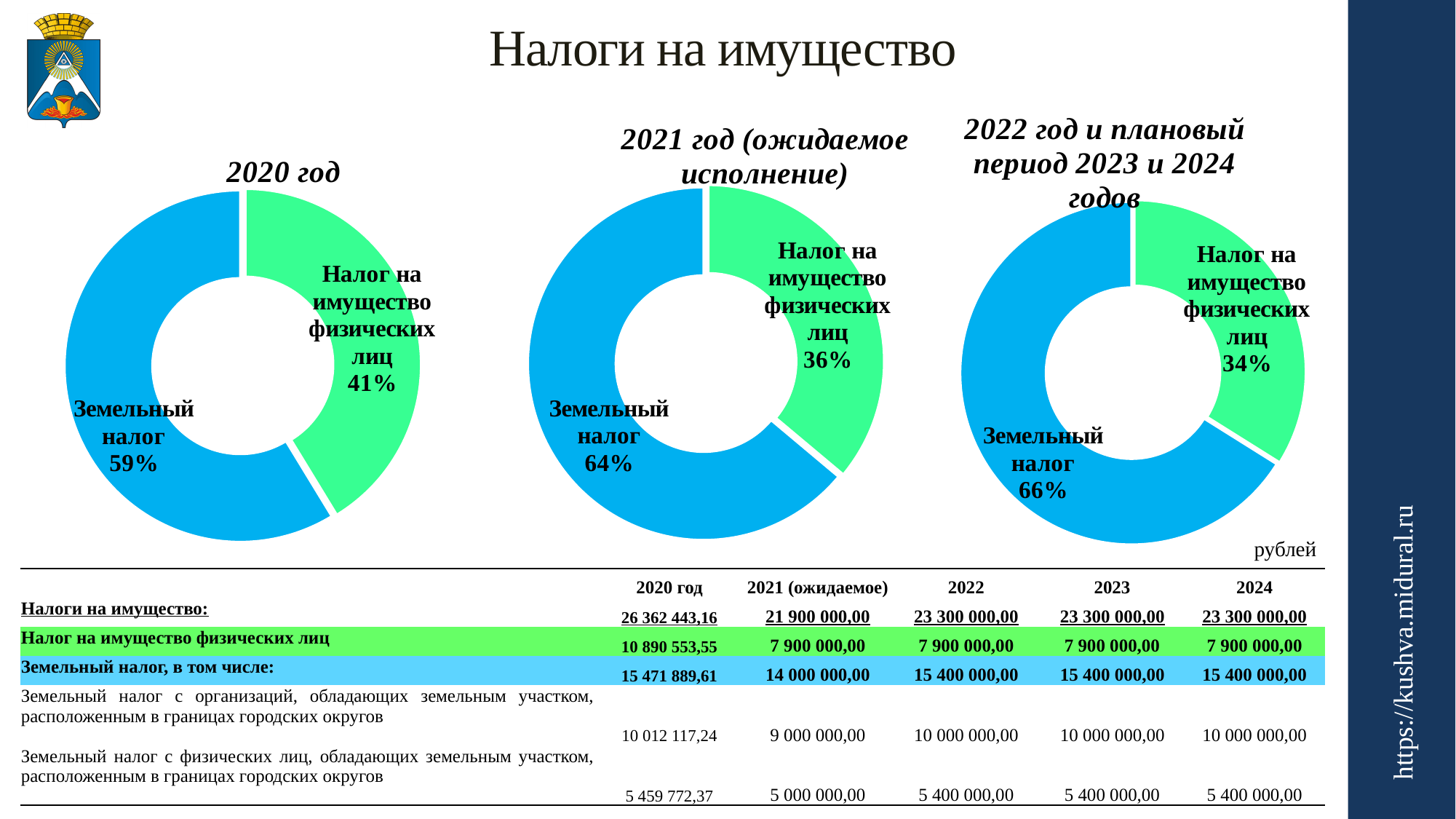
In the '2021 год (ожидаемое исполнение)' chart, what is the difference in percentage points between 'Земельный налог' and 'Налог на имущество физических лиц'? 28 In the '2020 год' chart, which slice is the largest? Земельный налог In the '2021 год (ожидаемое исполнение)' chart, what share does 'Земельный налог' have? 64% In the '2020 год' chart, what share does 'Земельный налог' have? 59% What kind of chart is the '2020 год' chart? Pie chart (donut) In the '2022 год и плановый период 2023 и 2024 годов' chart, what share does 'Земельный налог' have? 66% How many slices does the '2021 год (ожидаемое исполнение)' chart have? 2 In the '2022 год и плановый период 2023 и 2024 годов' chart, which slice is the smallest? Налог на имущество физических лиц Which is larger in the '2020 год' chart: the share of 'Земельный налог' or the share of 'Налог на имущество физических лиц'? Земельный налог